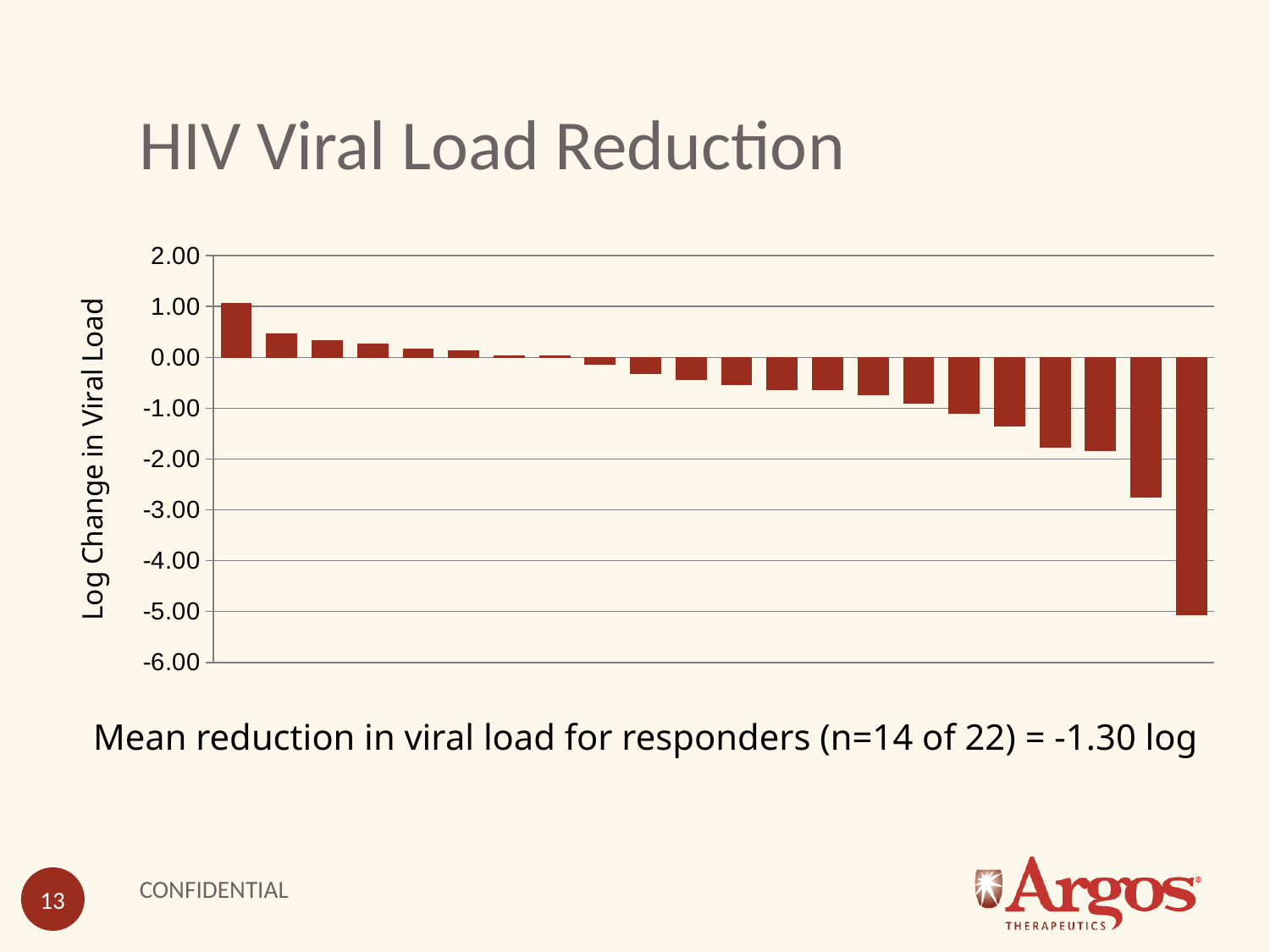
How many bars are plotted in the chart? 22 Is the value of the leftmost bar greater or less than 0.00? greater Which bar has the highest value? The leftmost bar What is the label of the vertical axis? Log Change in Viral Load How many bars extend below 0.00 on the vertical axis? 14 Is the value of the leftmost bar larger or smaller than the value of the second bar from the left? Larger Which bar has the lowest value? The rightmost bar Do the bar values rise or fall moving from left to right along the x axis? Fall Is the value of the second bar from the right greater or less than -2.00? less What kind of chart is shown on the slide? Bar chart Is the value of the rightmost bar greater or less than -4.00? less What is the title of the slide containing the chart? HIV Viral Load Reduction